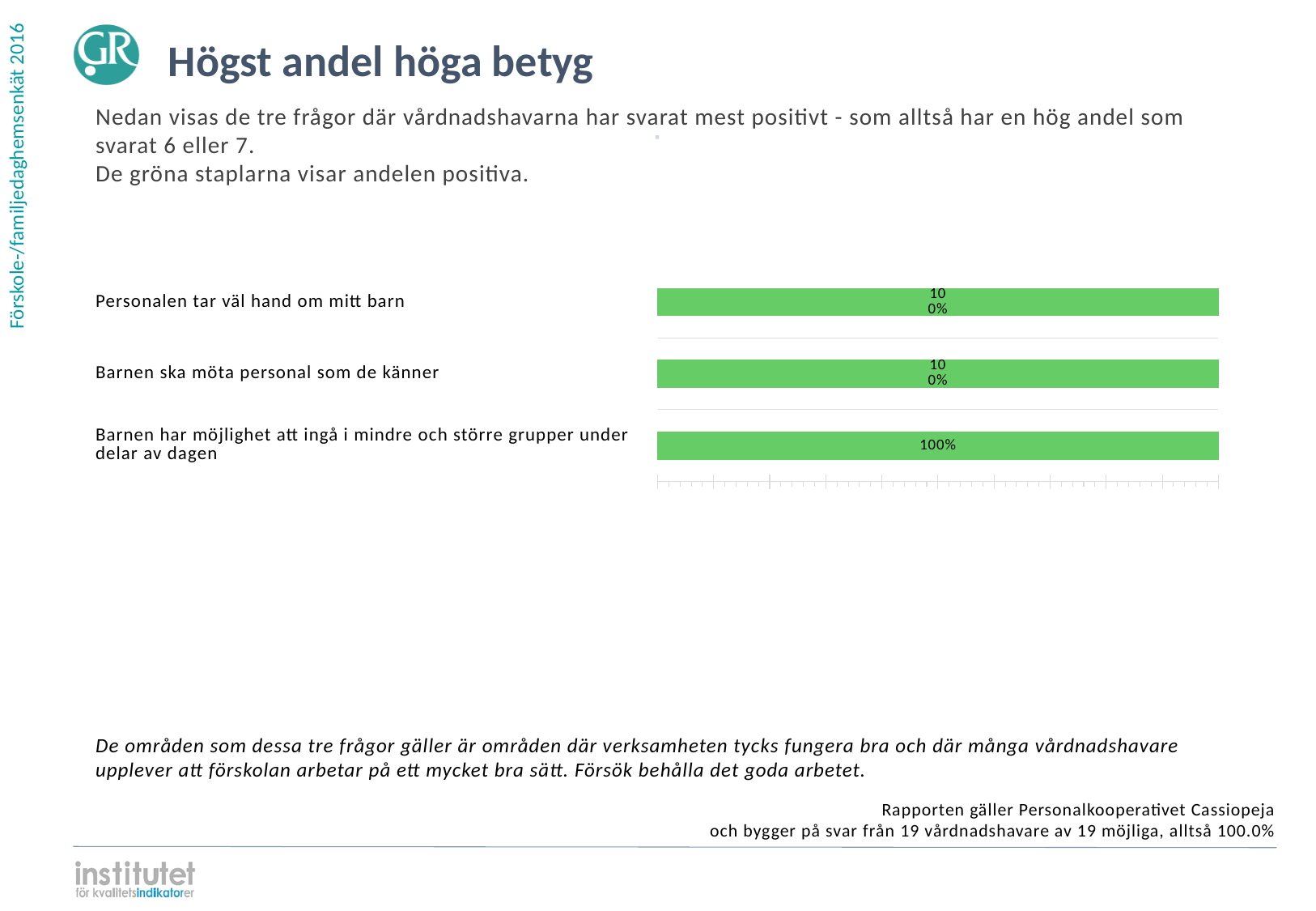
What is the difference between the values for "Personalen tar väl hand om mitt barn" and "Barnen ska möta personal som de känner"? 0% What colour are the bars in the chart? green What is the difference between the values for "Barnen ska möta personal som de känner" and "Barnen har möjlighet att ingå i mindre och större grupper under delar av dagen"? 0% What is the value shown for "Barnen ska möta personal som de känner"? 100% Do all three bars in the chart show the same value? yes What is the value shown for "Barnen har möjlighet att ingå i mindre och större grupper under delar av dagen"? 100% How many categories (questions) are plotted in the chart? 3 Which category is listed first (at the top) in the chart? Personalen tar väl hand om mitt barn What kind of chart is shown on the slide? bar chart What is the value shown for "Personalen tar väl hand om mitt barn"? 100%